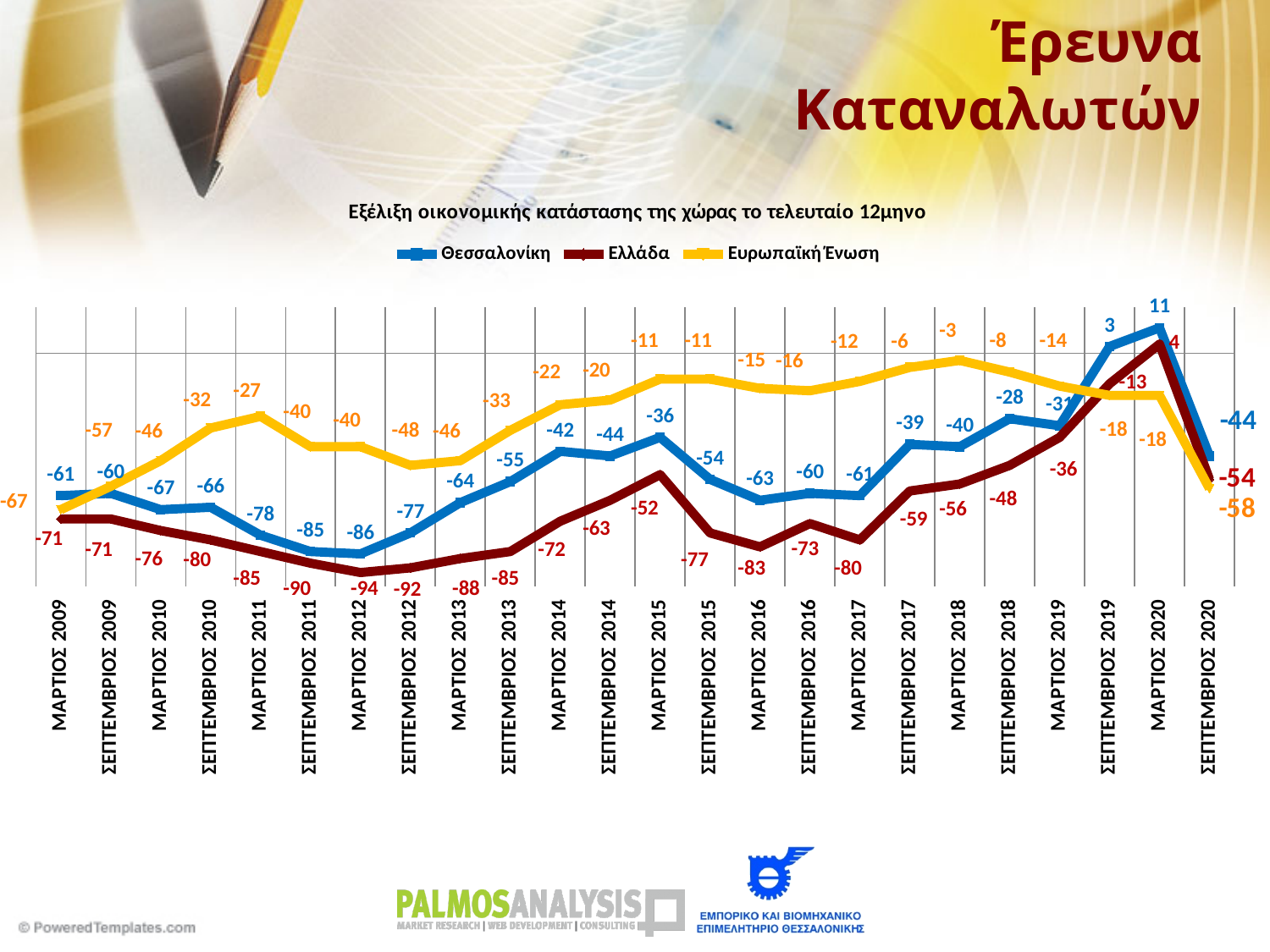
What kind of chart is shown on the slide? line chart In which period does the Θεσσαλονίκη series reach its lowest value? ΜΑΡΤΙΟΣ 2012 How many series does the legend list? 3 What colour is the Ευρωπαϊκή Ένωση line? yellow What is the value for Ελλάδα in ΜΑΡΤΙΟΣ 2012? -94 What is the value for Ελλάδα in ΣΕΠΤΕΜΒΡΙΟΣ 2019? -13 How many time points are plotted along the x axis? 24 What is the value for Ευρωπαϊκή Ένωση in ΣΕΠΤΕΜΒΡΙΟΣ 2020? -58 In which period does the Ελλάδα series reach its highest value? ΜΑΡΤΙΟΣ 2020 What is the difference between the Θεσσαλονίκη and Ελλάδα values in ΣΕΠΤΕΜΒΡΙΟΣ 2020? 10 In ΜΑΡΤΙΟΣ 2015, which series has the higher value, Θεσσαλονίκη or Ελλάδα? Θεσσαλονίκη What is the value for Θεσσαλονίκη in ΜΑΡΤΙΟΣ 2020? 11